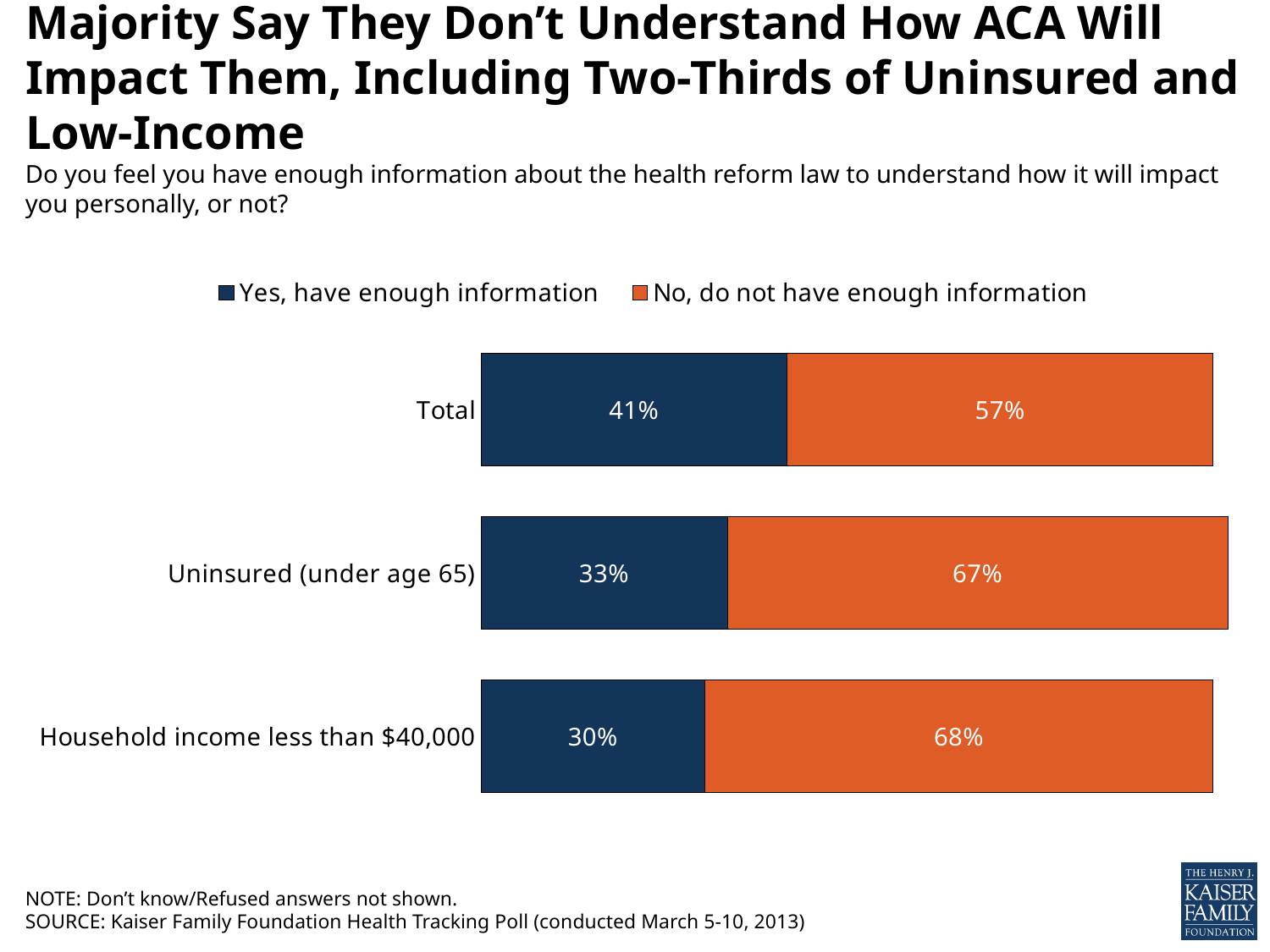
How many series does the legend list? 2 Which colour represents 'No, do not have enough information' in the chart? Orange What percentage of the Uninsured (under age 65) group say they do not have enough information? 67% Which group has the lowest share saying they have enough information? Household income less than $40,000 Which is larger: the 'Yes, have enough information' share for Total or for Uninsured (under age 65)? Total What kind of chart is shown on the slide? Stacked bar chart What percentage of the Total group say they have enough information? 41% What is the total of the two labelled segments for the Total bar? 98% Which group has the highest share saying they do not have enough information? Household income less than $40,000 How many groups are shown in the chart? 3 What percentage of those with household income less than $40,000 say they have enough information? 30% What is the difference between the 'No, do not have enough information' share for the Total group and for the Uninsured (under age 65) group? 10 percentage points